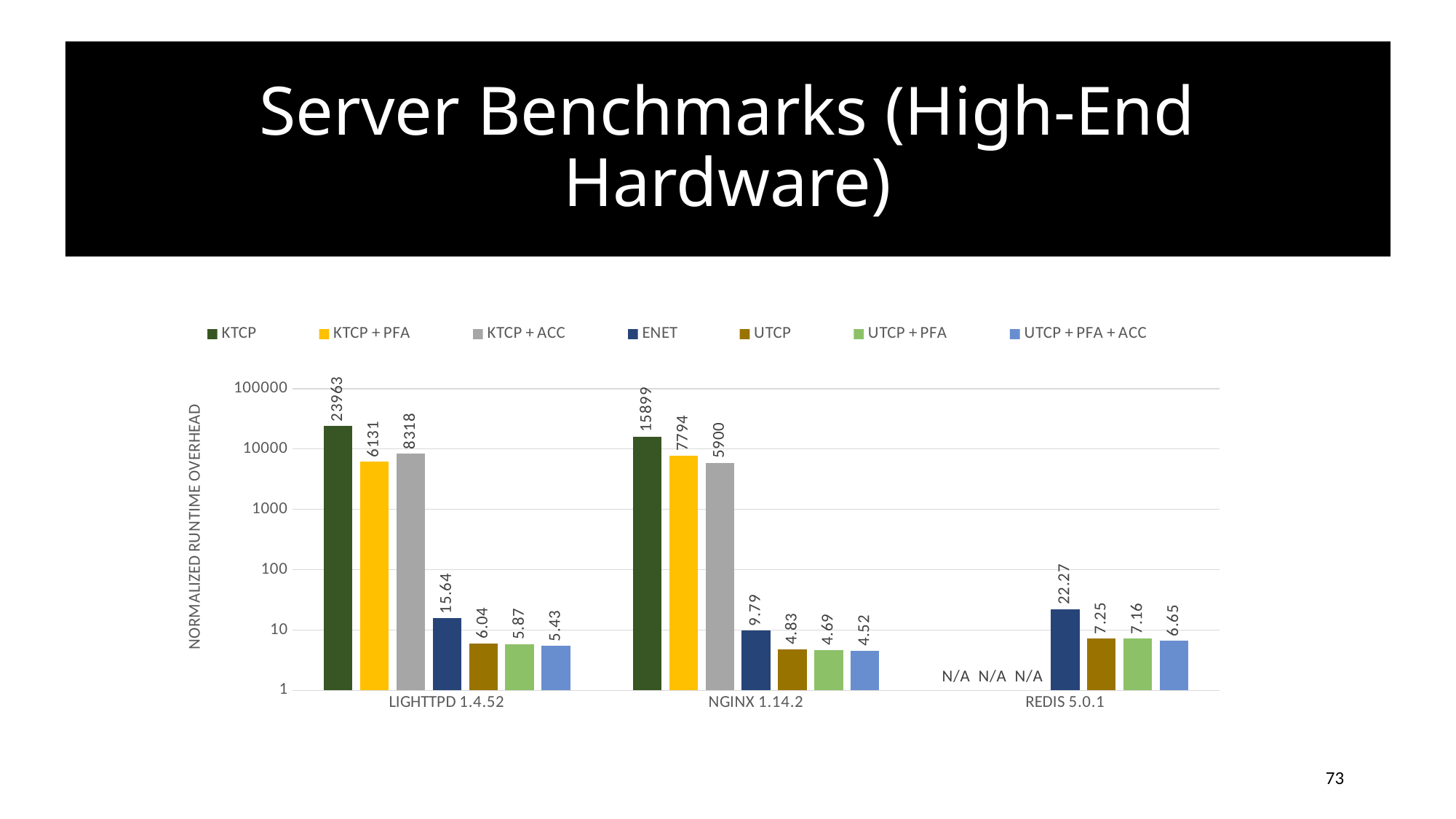
What is the value for UTCP + PFA + ACC on NGINX 1.14.2? 4.52 What is the difference between the KTCP + ACC and KTCP + PFA values for LIGHTTPD 1.4.52? 2187 What is the value for ENET on REDIS 5.0.1? 22.27 What is the value for KTCP on LIGHTTPD 1.4.52? 23963 Which series are marked N/A for REDIS 5.0.1? KTCP, KTCP + PFA, KTCP + ACC How many series does the legend list? 7 Which series has the lowest value for NGINX 1.14.2? UTCP + PFA + ACC What kind of chart is shown on the slide? bar chart What is the difference between the ENET and UTCP values for REDIS 5.0.1? 15.02 How many benchmark categories are shown on the x axis? 3 Which has the larger ENET value, LIGHTTPD 1.4.52 or NGINX 1.14.2? LIGHTTPD 1.4.52 Which benchmark has the highest KTCP value? LIGHTTPD 1.4.52